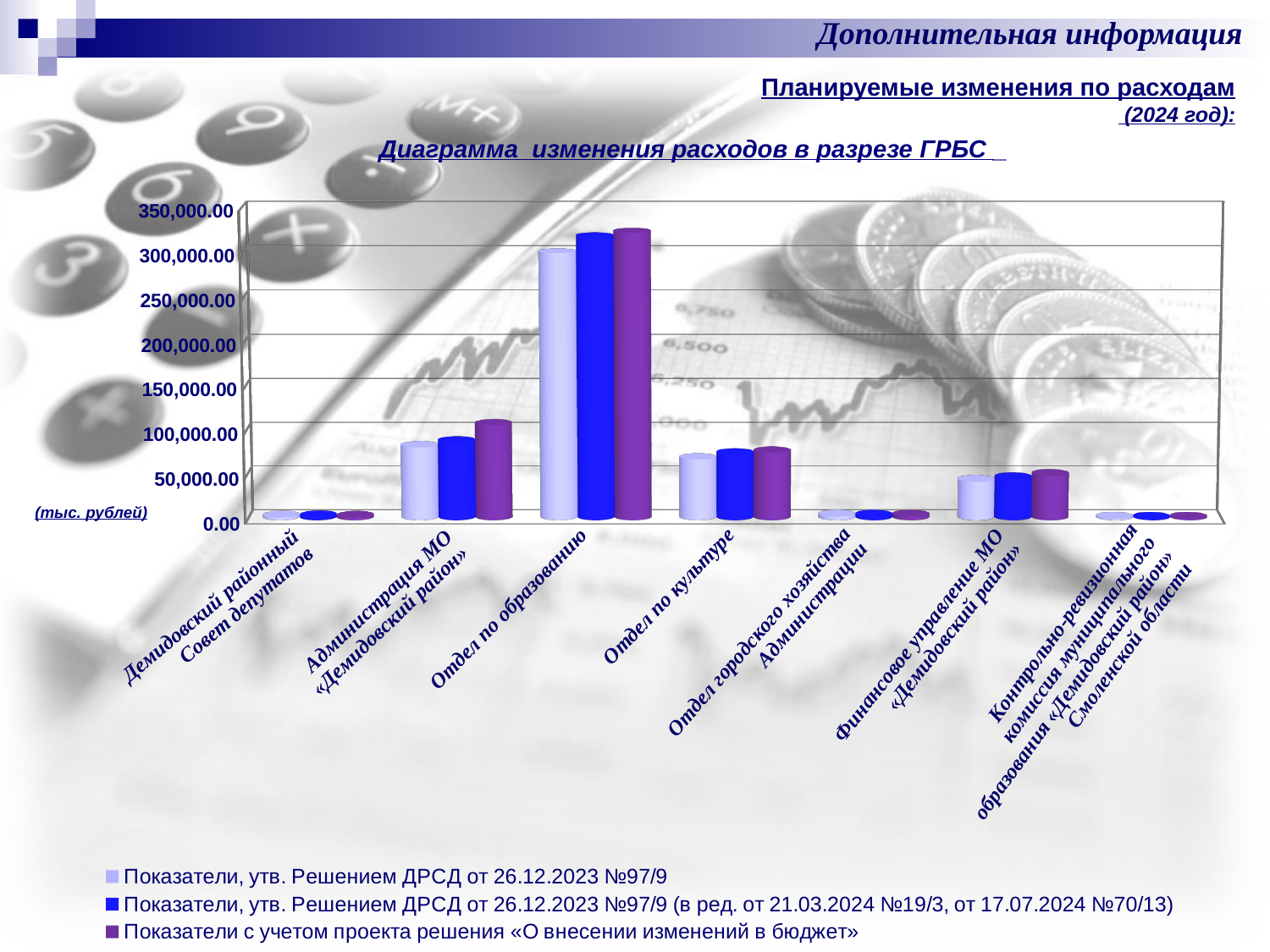
What is the title of the chart? Диаграмма изменения расходов в разрезе ГРБС Which has the larger value in the series «Показатели, утв. Решением ДРСД от 26.12.2023 №97/9»: Отдел по образованию or Отдел по культуре? Отдел по образованию Is the value for Отдел по образованию in the series «Показатели с учетом проекта решения «О внесении изменений в бюджет»» greater or less than 300,000.00? greater Which has the larger value in the series «Показатели с учетом проекта решения «О внесении изменений в бюджет»»: Администрация МО «Демидовский район» or Финансовое управление МО «Демидовский район»? Администрация МО «Демидовский район» In what units are the chart values given, according to the label next to the vertical axis? тыс. рублей How many series does the chart legend list? 3 Which category has the highest values in the chart? Отдел по образованию How many categories (ГРБС) are shown along the x axis of the chart? 7 What kind of chart is shown on the slide? bar chart Is the value for Финансовое управление МО «Демидовский район» in the series «Показатели, утв. Решением ДРСД от 26.12.2023 №97/9» greater or less than 100,000.00? less Is the value for Администрация МО «Демидовский район» in the series «Показатели, утв. Решением ДРСД от 26.12.2023 №97/9» greater or less than 150,000.00? less